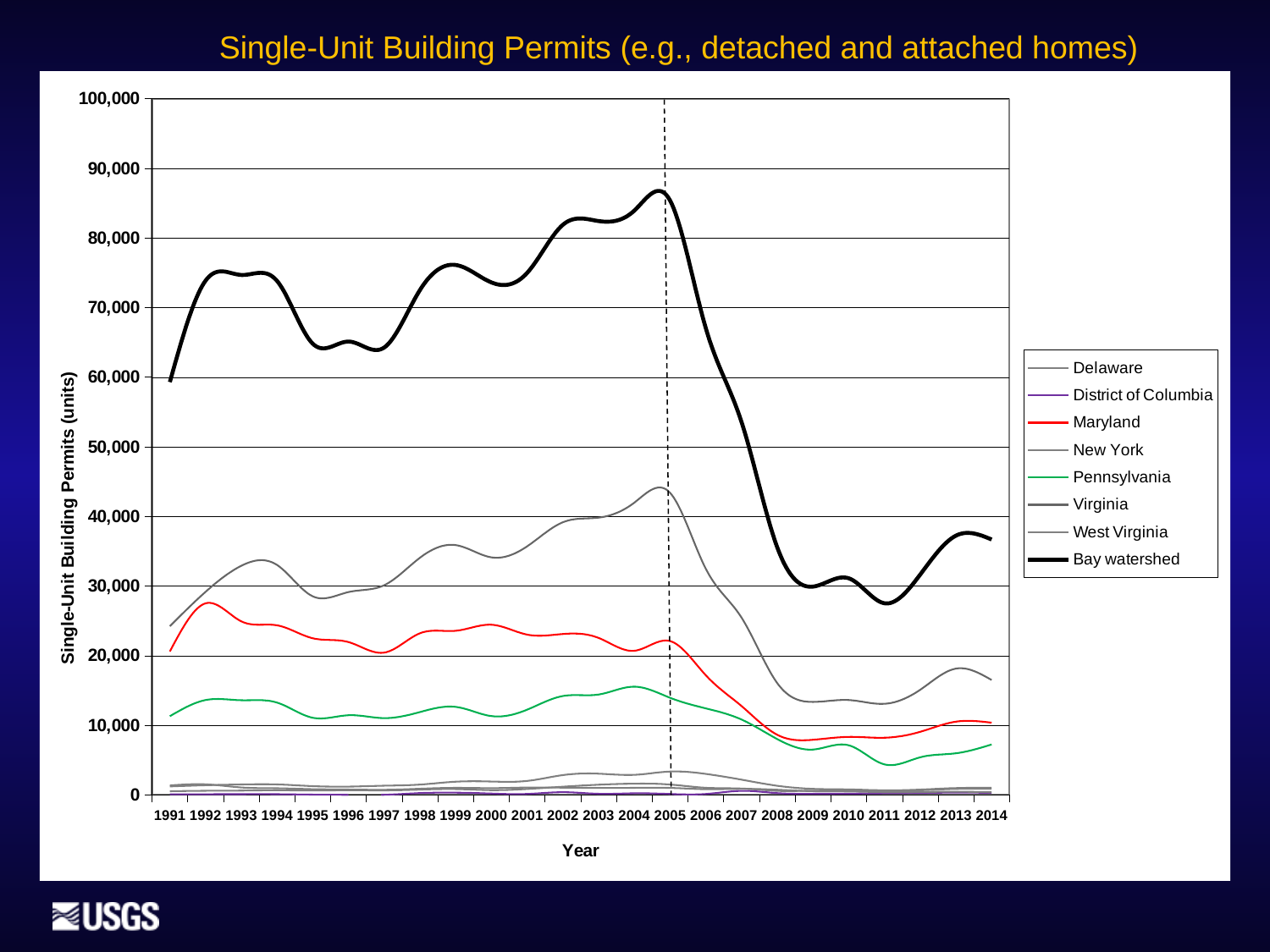
Which series has the highest values across the chart? Bay watershed Does the Bay watershed series rise or fall between 2005 and 2009? fall Is the value for Maryland in 1992 greater or less than 20,000? greater What is the label on the y axis? Single-Unit Building Permits (units) How many series does the legend list? 8 Is the value for Bay watershed in 2009 greater or less than 40,000? less Is the value for Pennsylvania in 2004 greater or less than 10,000? greater What kind of chart is shown on the slide? line chart In which year does the Bay watershed series reach its highest value? 2005 How many years are shown along the x axis? 24 In 2005, which is larger: the value for Maryland or the value for Pennsylvania? Maryland